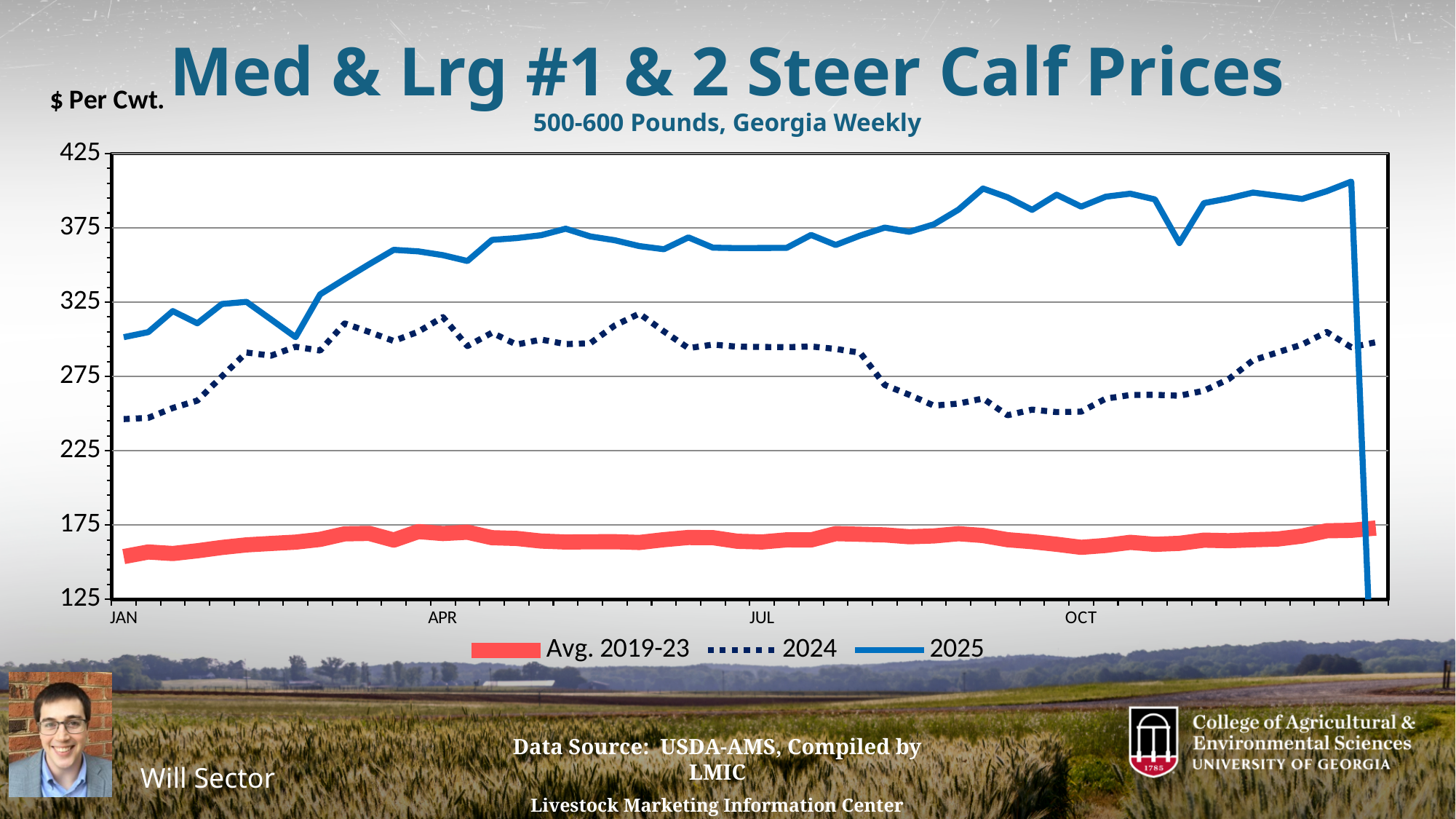
Which series is higher in July, 2025 or 2024? 2025 Which series has the lowest values across the whole year? Avg. 2019-23 Is the value for the 2025 series in January greater or less than 275? greater Is the value for the 2024 series in January greater or less than 275? less Is the value for the 2024 series in October greater or less than 275? less Does the 2025 series generally rise or fall from January to October? Rise What kind of chart is shown on the slide? Line chart How many series does the legend list? 3 What is the subtitle of the chart below the main title? 500-600 Pounds, Georgia Weekly What are the three series listed in the legend? Avg. 2019-23, 2024, 2025